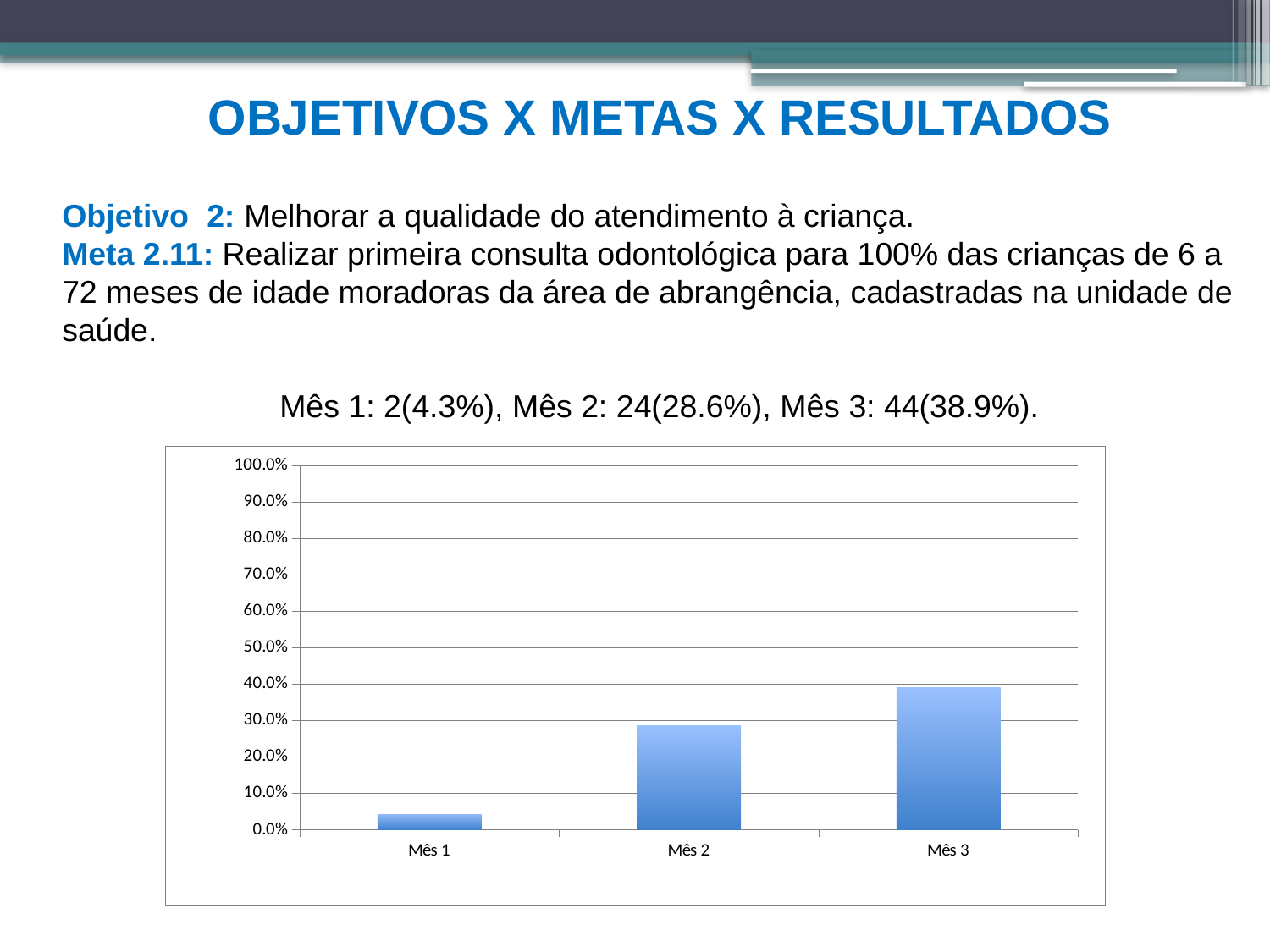
Which month has the highest bar on the chart? Mês 3 How many categories (months) are plotted on the chart? 3 What is the highest value shown on the chart's vertical axis? 100.0% Which is larger, the bar for Mês 2 or the bar for Mês 3? Mês 3 Which month has the lowest bar on the chart? Mês 1 According to the text above the chart, what percentage is shown for Mês 3? 38.9% According to the text above the chart, what percentage is shown for Mês 2? 28.6% Is the bar for Mês 1 greater or less than 10.0%? less Is the bar for Mês 2 greater or less than 20.0%? greater Do the bar values rise or fall from Mês 1 to Mês 3? rise What kind of chart is shown on the slide? bar chart